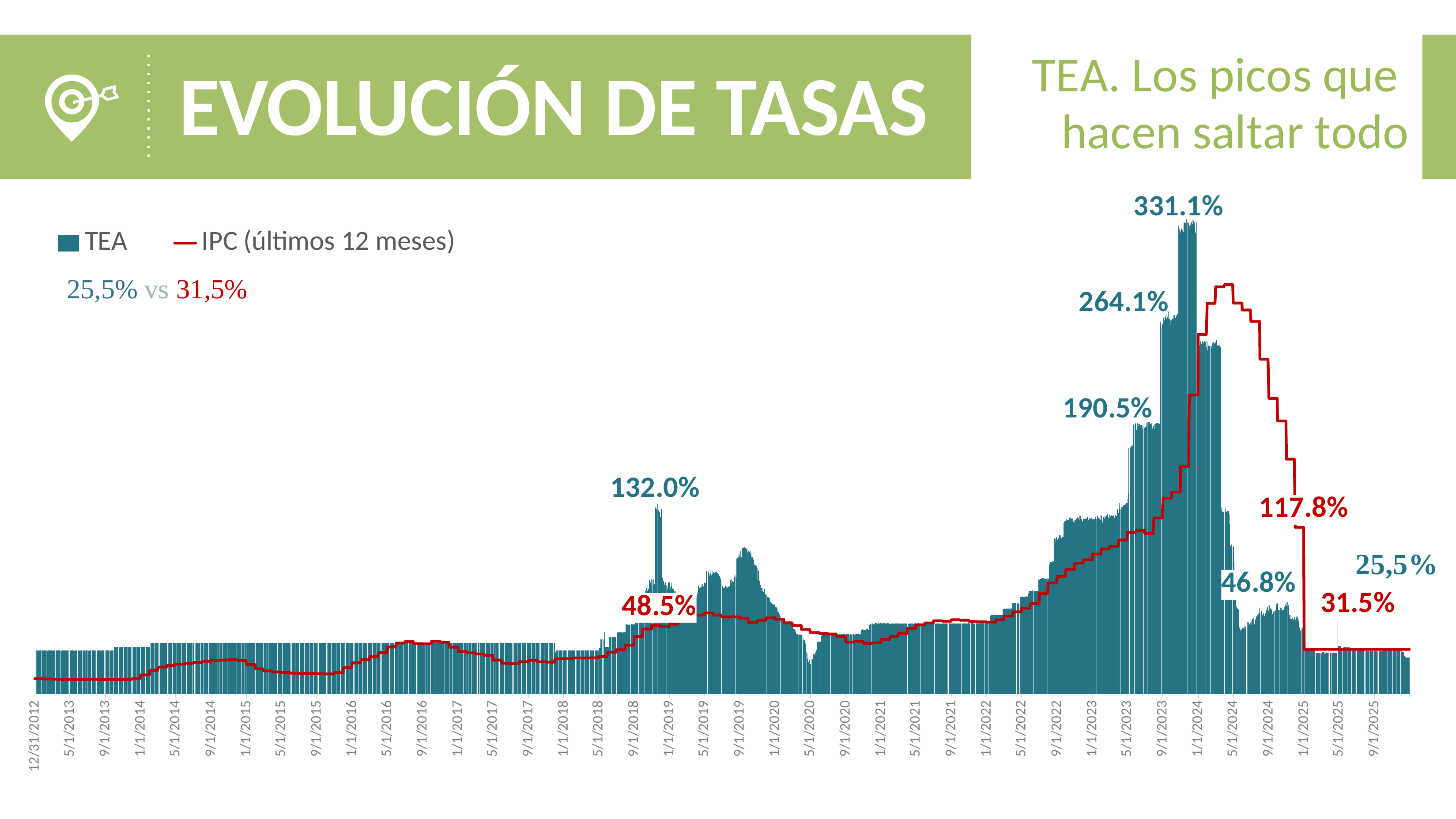
What is the TEA value labelled just before the 331.1% peak, in 2023? 264.1% What is the most recent TEA value labelled at the right end of the chart? 25,5% What is the TEA value labelled at the step up in mid-2023? 190.5% Does the TEA series rise or fall from its peak in late 2023 to the end of 2025? Fall What is the IPC (últimos 12 meses) value labelled in early 2025, just before its sharp drop? 117.8% At the right end of the chart, which is larger: the latest TEA value or the latest IPC value? IPC (31.5%) What is the difference between the two highest labelled TEA values, 331.1% and 264.1%? 67.0 percentage points How many series does the legend list? 2 What is the TEA value labelled in the second half of 2024? 46.8% What is the TEA value labelled at the peak around late 2018 / early 2019? 132.0% What is the highest TEA value labelled on the chart? 331.1% What is the most recent IPC (últimos 12 meses) value labelled at the right end of the chart? 31.5%